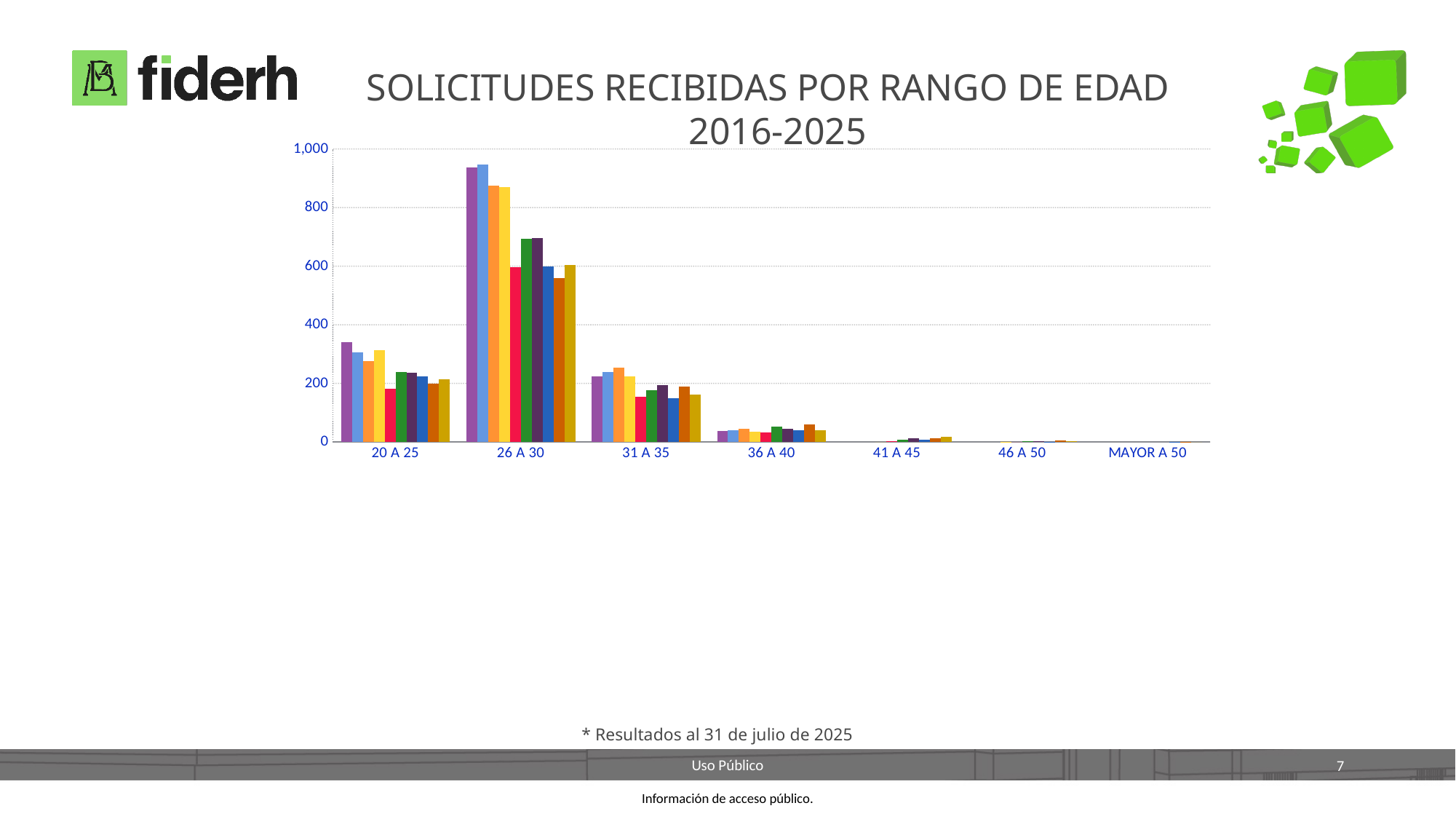
Which group has larger values, 20 A 25 or 36 A 40? 20 A 25 How many age-range categories are shown on the x axis? 7 What is the highest value shown on the vertical axis? 1,000 Are all the bars in the 31 A 35 group greater or less than 400? less Which age range has the highest bars? 26 A 30 What kind of chart is shown on the slide? bar chart Do the values rise or fall along the x axis from 26 A 30 to MAYOR A 50? fall Are the bars in the 36 A 40 group greater or less than 200? less What is the title of the chart? SOLICITUDES RECIBIDAS POR RANGO DE EDAD 2016-2025 Are the tallest bars in the 26 A 30 group greater or less than 800? greater Which group has larger values, 26 A 30 or 31 A 35? 26 A 30